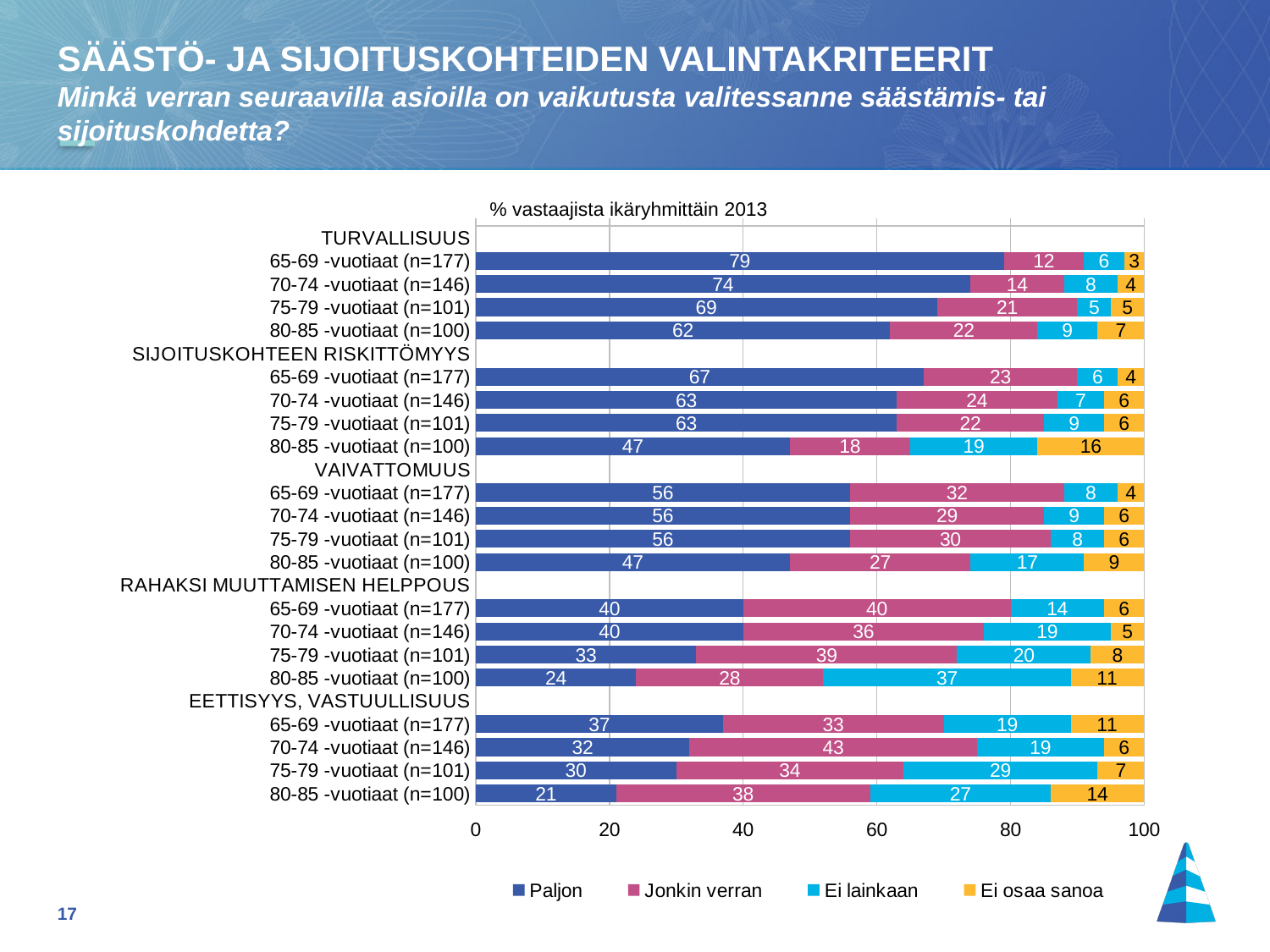
Under TURVALLISUUS, what is the difference between the Paljon value for 65-69 -vuotiaat (n=177) and for 80-85 -vuotiaat (n=100)? 17 What is the Ei osaa sanoa value for 80-85 -vuotiaat (n=100) under SIJOITUSKOHTEEN RISKITTÖMYYS? 16 Which is larger: the Jonkin verran value for 65-69 -vuotiaat (n=177) under RAHAKSI MUUTTAMISEN HELPPOUS or for 70-74 -vuotiaat (n=146) under EETTISYYS, VASTUULLISUUS? 70-74 -vuotiaat (n=146) under EETTISYYS, VASTUULLISUUS Under EETTISYYS, VASTUULLISUUS, which age group has the lowest Paljon value? 80-85 -vuotiaat (n=100) What is the total of the stacked bar for 65-69 -vuotiaat (n=177) under TURVALLISUUS? 100 What kind of chart is shown on the slide? Stacked horizontal bar chart What is the title of the chart? % vastaajista ikäryhmittäin 2013 What is the Ei lainkaan value for 80-85 -vuotiaat (n=100) under RAHAKSI MUUTTAMISEN HELPPOUS? 37 How many series does the legend list? 4 Under TURVALLISUUS, which age group has the highest Paljon value? 65-69 -vuotiaat (n=177) Under TURVALLISUUS, does the Paljon value rise or fall from the 65-69 age group to the 80-85 age group? Fall What is the Paljon value for 65-69 -vuotiaat (n=177) under TURVALLISUUS? 79